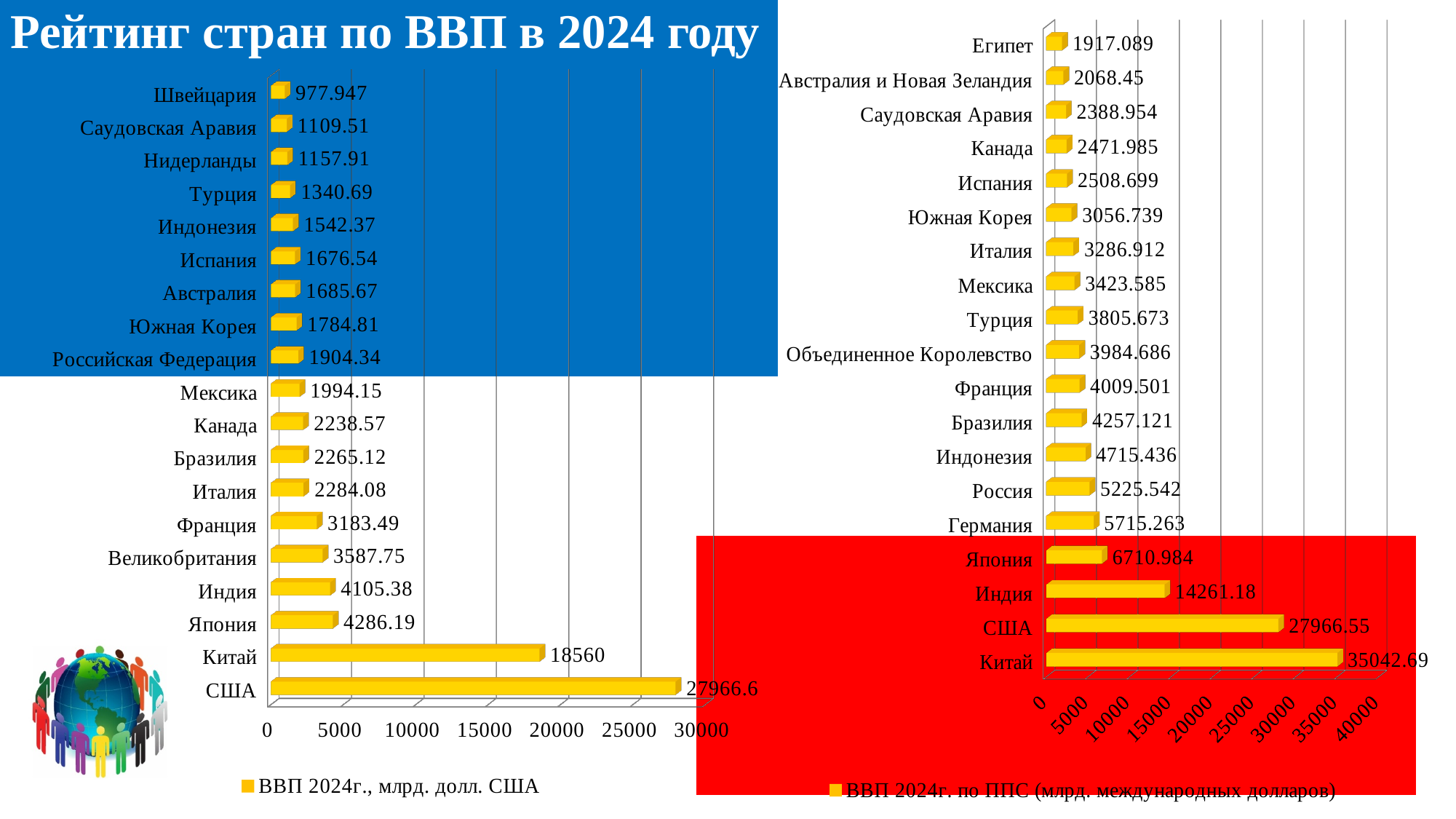
On the left chart (ВВП 2024г., млрд. долл. США), which is larger: the value for Япония or the value for Индия? Япония On the left chart (ВВП 2024г., млрд. долл. США), what is the difference between the values for США and Китай? 9406.6 On the right chart (ВВП 2024г. по ППС), what is the value for Индия? 14261.18 How many categories are shown on the right chart (ВВП 2024г. по ППС)? 19 On the right chart (ВВП 2024г. по ППС), what is the difference between the values for Китай and США? 7076.14 On the right chart (ВВП 2024г. по ППС), is the value for Германия greater or less than 5000? greater On the right chart (ВВП 2024г. по ППС), which country has the lowest value? Египет What is the legend entry of the left chart? ВВП 2024г., млрд. долл. США How many countries are shown on the left chart (ВВП 2024г., млрд. долл. США)? 19 What type of chart is the right chart (ВВП 2024г. по ППС)? Bar chart On the left chart (ВВП 2024г., млрд. долл. США), which country has the highest value? США On the left chart (ВВП 2024г., млрд. долл. США), what is the value for Китай? 18560